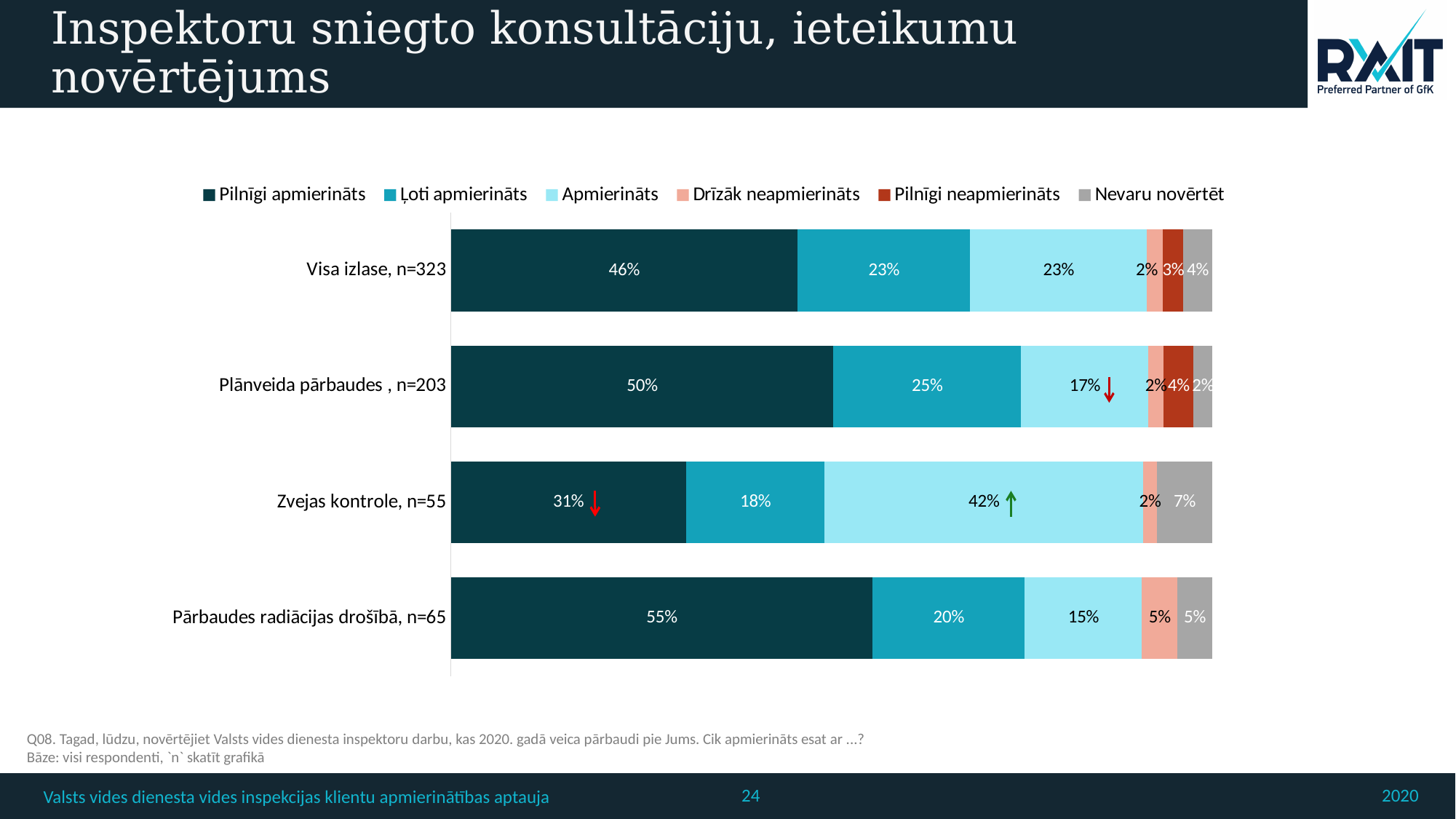
What is the 'Pilnīgi apmierināts' value for 'Visa izlase, n=323'? 46% What kind of chart is shown on the slide? Stacked bar chart What is the 'Nevaru novērtēt' value for 'Zvejas kontrole, n=55'? 7% Which category has the lowest 'Pilnīgi apmierināts' value? Zvejas kontrole, n=55 What is the 'Drīzāk neapmierināts' value for 'Pārbaudes radiācijas drošībā, n=65'? 5% What is the difference between the 'Pilnīgi apmierināts' values for 'Pārbaudes radiācijas drošībā, n=65' and 'Zvejas kontrole, n=55'? 24 percentage points Which is larger: the 'Apmierināts' value for 'Visa izlase, n=323' or for 'Plānveida pārbaudes , n=203'? Visa izlase, n=323 How many series does the legend list? 6 Which category has the highest 'Pilnīgi apmierināts' value? Pārbaudes radiācijas drošībā, n=65 How many categories (bars) are shown in the chart? 4 What is the 'Apmierināts' value for 'Zvejas kontrole, n=55'? 42% What is the 'Ļoti apmierināts' value for 'Plānveida pārbaudes , n=203'? 25%